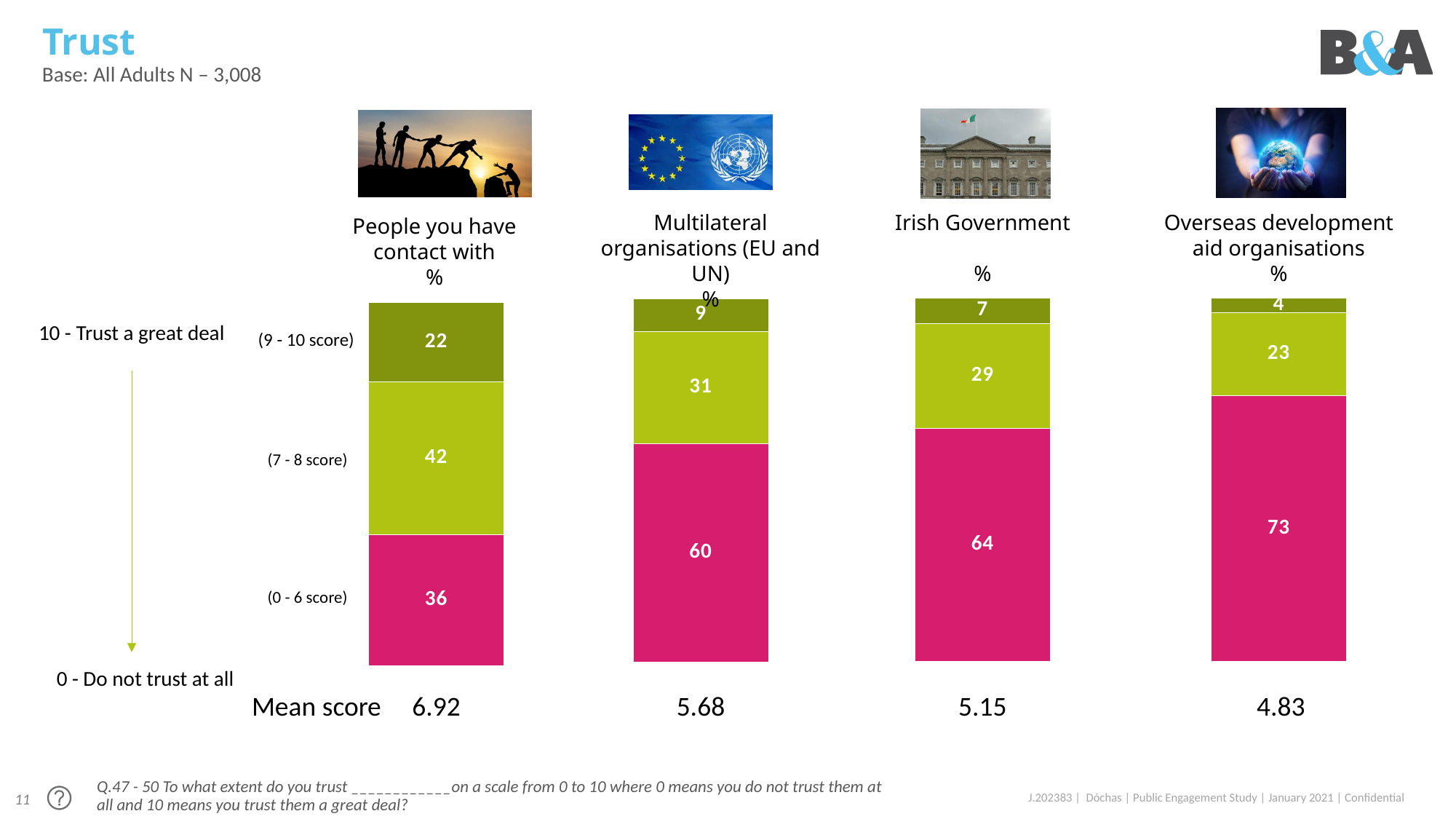
How many groups (bars) are shown in the chart? 4 What is the mean trust score for multilateral organisations (EU and UN)? 5.68 Which group has the highest share of 9-10 scores? People you have contact with What is the difference between the 0-6 score percentages for overseas development aid organisations and people you have contact with? 37 Which is larger: the 7-8 score share for multilateral organisations or for the Irish Government? Multilateral organisations What percentage gave a 0-6 score for trust in overseas development aid organisations? 73 What kind of chart is shown on the slide? Stacked bar chart How many score bands make up each stacked bar? 3 What is the total of the three segments in the bar for people you have contact with? 100 What percentage of adults gave a 9-10 score for trust in the Irish Government? 7 Which group has the lowest mean trust score? Overseas development aid organisations What is the base size stated on the slide? All Adults N – 3,008